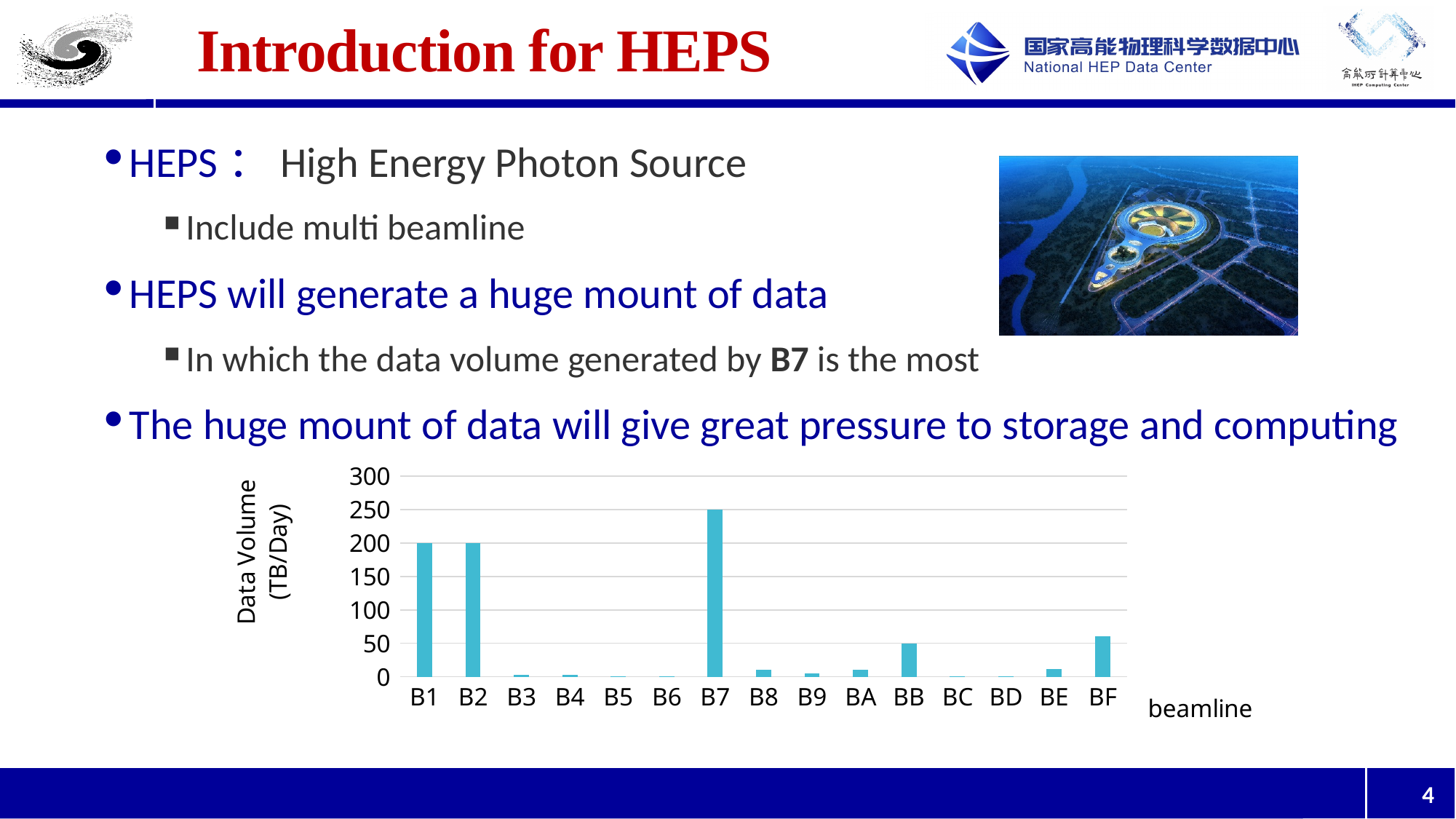
Is the value for BF greater or less than 50? greater Which beamline has the highest data volume in the chart? B7 What is the difference in data volume (TB/Day) between B7 and B1? 50 Is the value for B8 greater or less than 50? less What is the label of the y axis of the chart? Data Volume (TB/Day) What is the data volume (TB/Day) for beamline B7? 250 Which has a larger data volume, B7 or B2? B7 What is the data volume (TB/Day) for beamline B1? 200 What kind of chart is shown on the slide? bar chart What is the label of the x axis of the chart? beamline How many beamlines are shown on the x axis of the chart? 15 What is the data volume (TB/Day) for beamline BB? 50